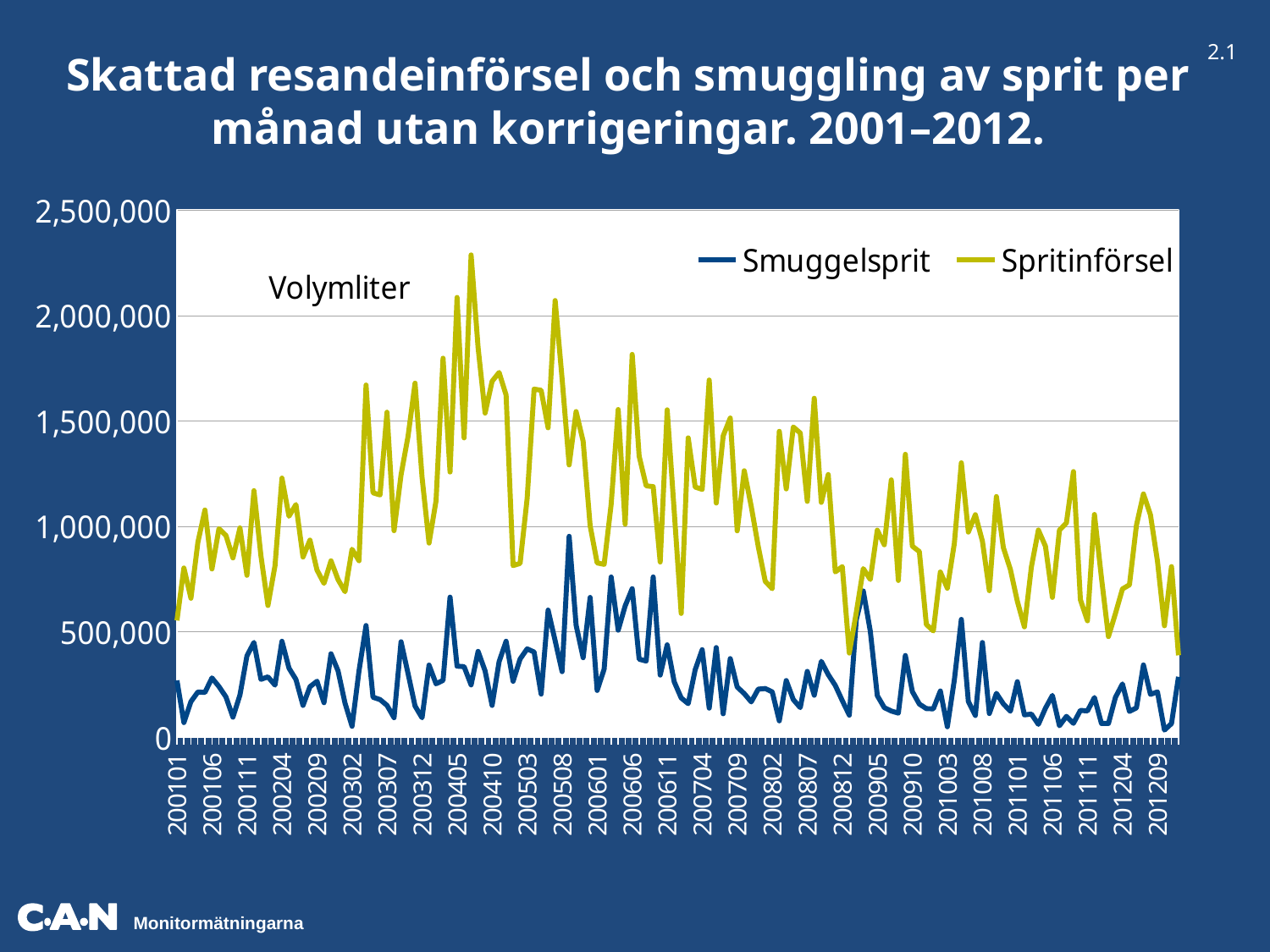
Do the Spritinförsel values generally rise or fall from 2005 to 2012? fall Is the value for Smuggelsprit at 200101 greater or less than 500,000? less How many series does the legend list? 2 Which series has the higher values throughout the period, Smuggelsprit or Spritinförsel? Spritinförsel What are the two series named in the legend? Smuggelsprit and Spritinförsel Is the highest value of the Smuggelsprit series greater or less than 1,000,000? less Is the highest value of the Spritinförsel series greater or less than 2,000,000? greater What unit label is printed inside the plot area? Volymliter What is the highest value shown on the vertical axis? 2,500,000 What kind of chart is shown on the slide? Line chart